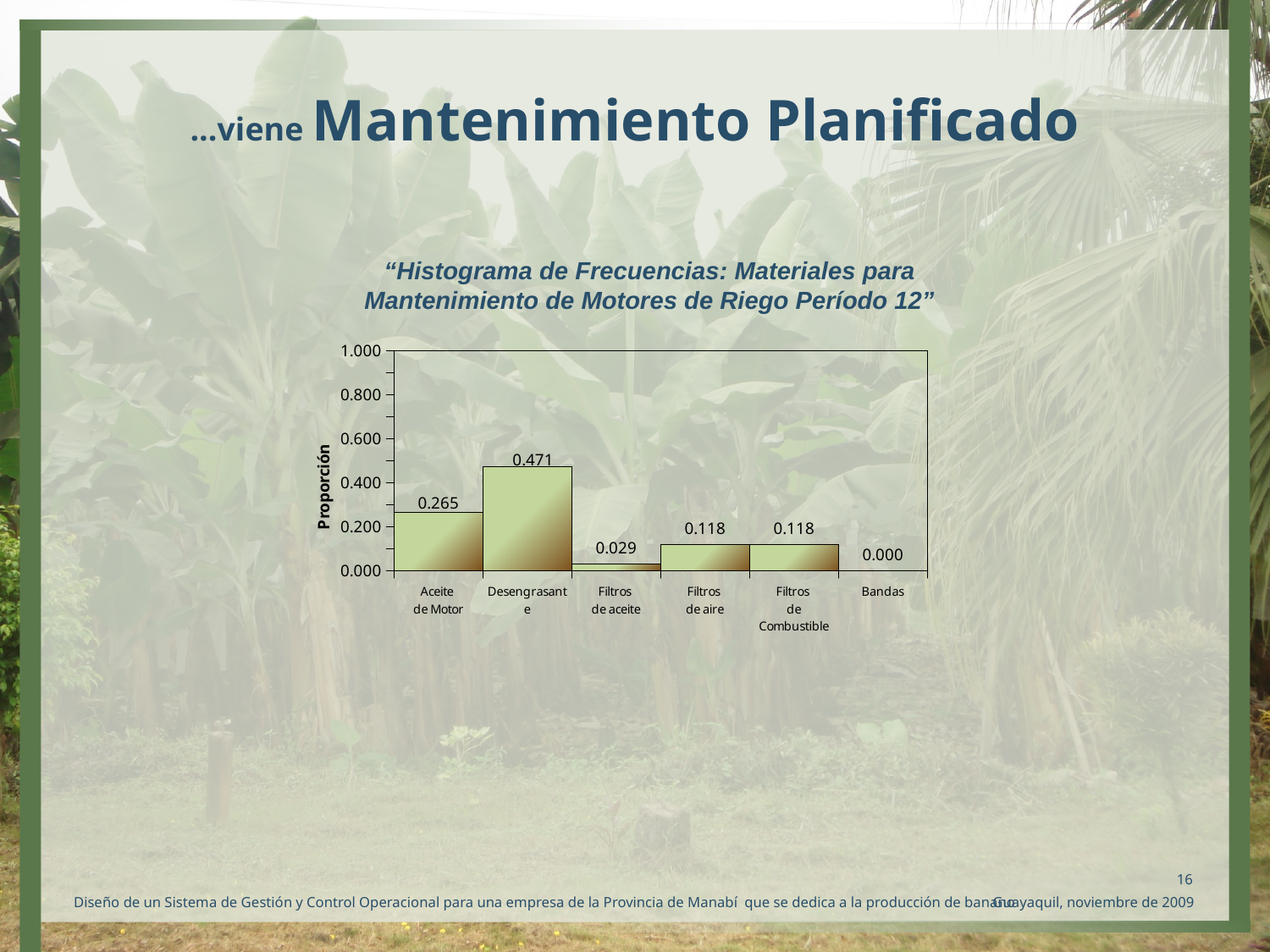
Which category has the lowest value? Bandas What kind of chart is shown on the slide? bar chart What is the label of the vertical axis? Proporción Is the value for Desengrasante greater or less than 0.400? greater What is the value for Aceite de Motor? 0.265 What is the difference between the values for Desengrasante and Aceite de Motor? 0.206 What is the value for Bandas? 0.000 Which is larger, the value for Aceite de Motor or the value for Filtros de aire? Aceite de Motor How many categories are shown on the x axis? 6 Which category has the highest value? Desengrasante What is the value for Desengrasante? 0.471 What is the value for Filtros de aceite? 0.029